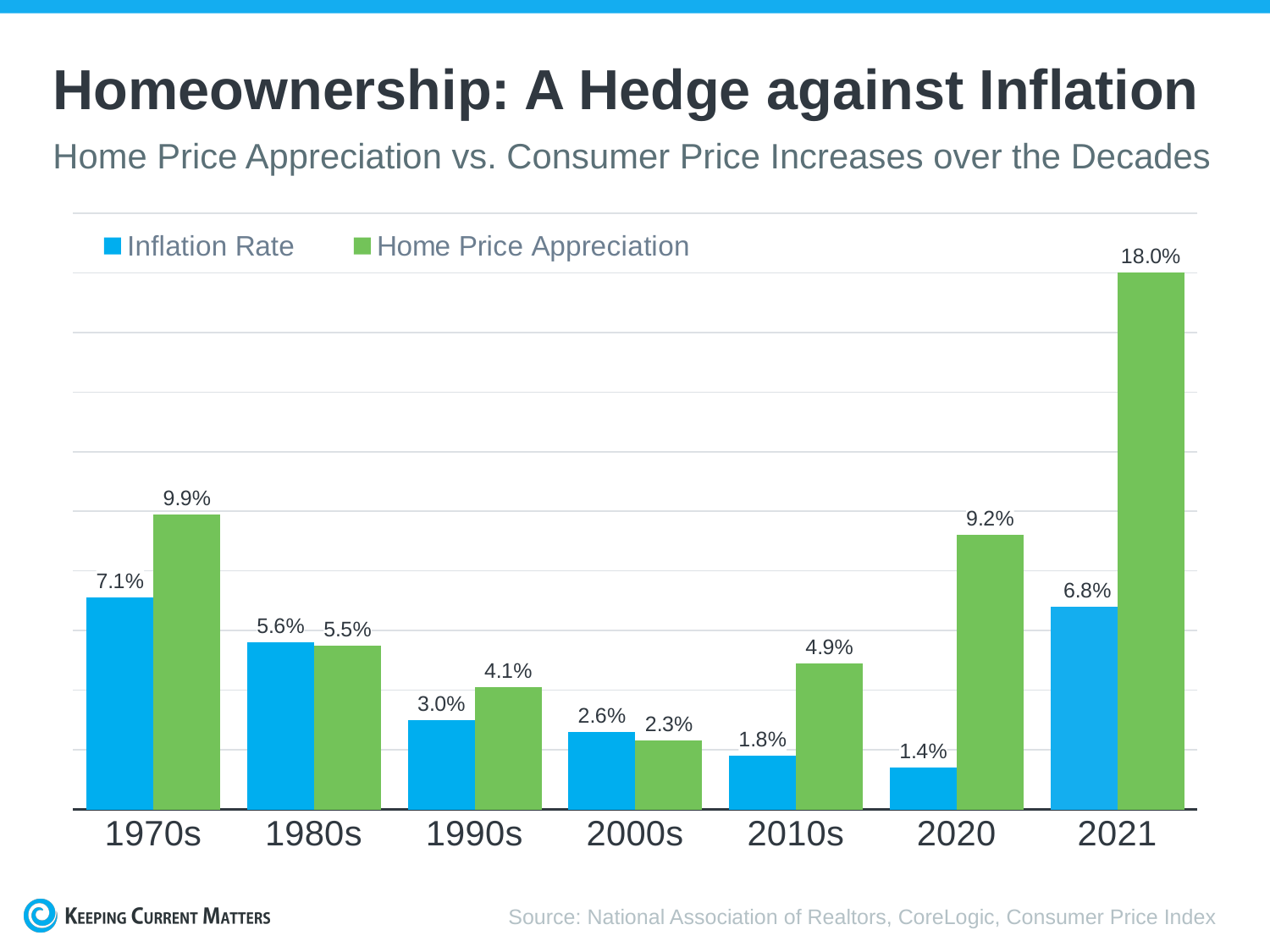
How many series does the legend list? 2 What kind of chart is shown on the slide? Bar chart What is the Inflation Rate for the 1970s? 7.1% What is the Home Price Appreciation value for the 2010s? 4.9% Does the Inflation Rate rise or fall from the 1970s to the 2000s? Fall Which colour represents Home Price Appreciation in the legend? Green Which is larger in the 2000s, the Inflation Rate or Home Price Appreciation? Inflation Rate What is the Home Price Appreciation value for 2021? 18.0% How many categories are shown on the x axis? 7 Which category has the highest Home Price Appreciation? 2021 What is the difference between Home Price Appreciation and Inflation Rate in 2020? 7.8% Which category has the lowest Inflation Rate? 2020